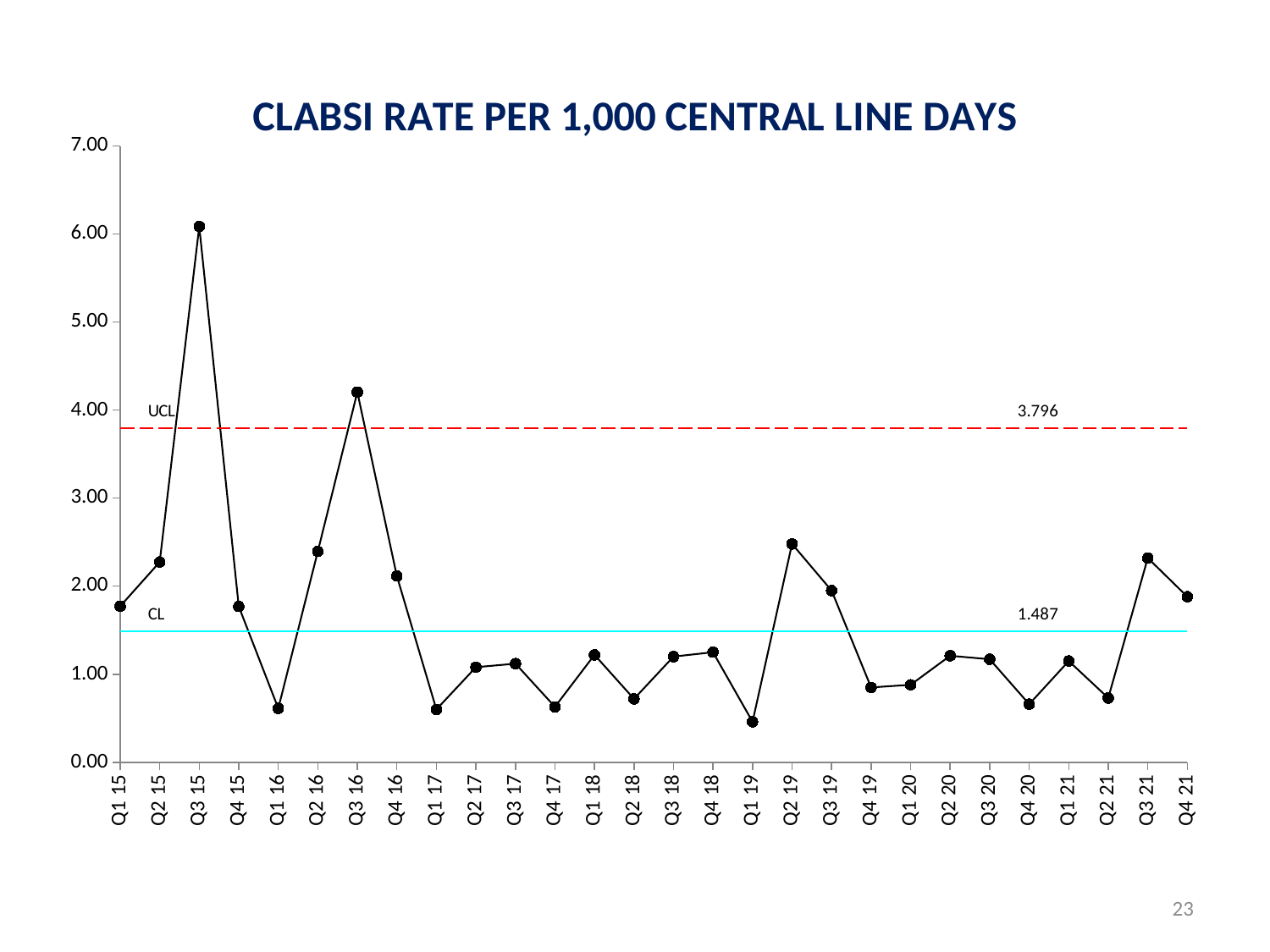
What kind of chart is shown on the slide? Line chart What is the difference between the UCL value and the CL value? 2.309 What is the value of the CL line? 1.487 How many data points lie above the UCL line? 2 Which is larger, the value for Q3 15 or the value for Q3 16? Q3 15 Which quarter has the lowest CLABSI rate? Q1 19 How many quarterly data points are plotted on the chart? 28 Is the value for Q3 15 greater or less than 5.00? greater Is the value for Q1 16 greater or less than 1.00? less What is the value of the UCL line? 3.796 What is the title of the chart? CLABSI RATE PER 1,000 CENTRAL LINE DAYS Which quarter has the highest CLABSI rate? Q3 15